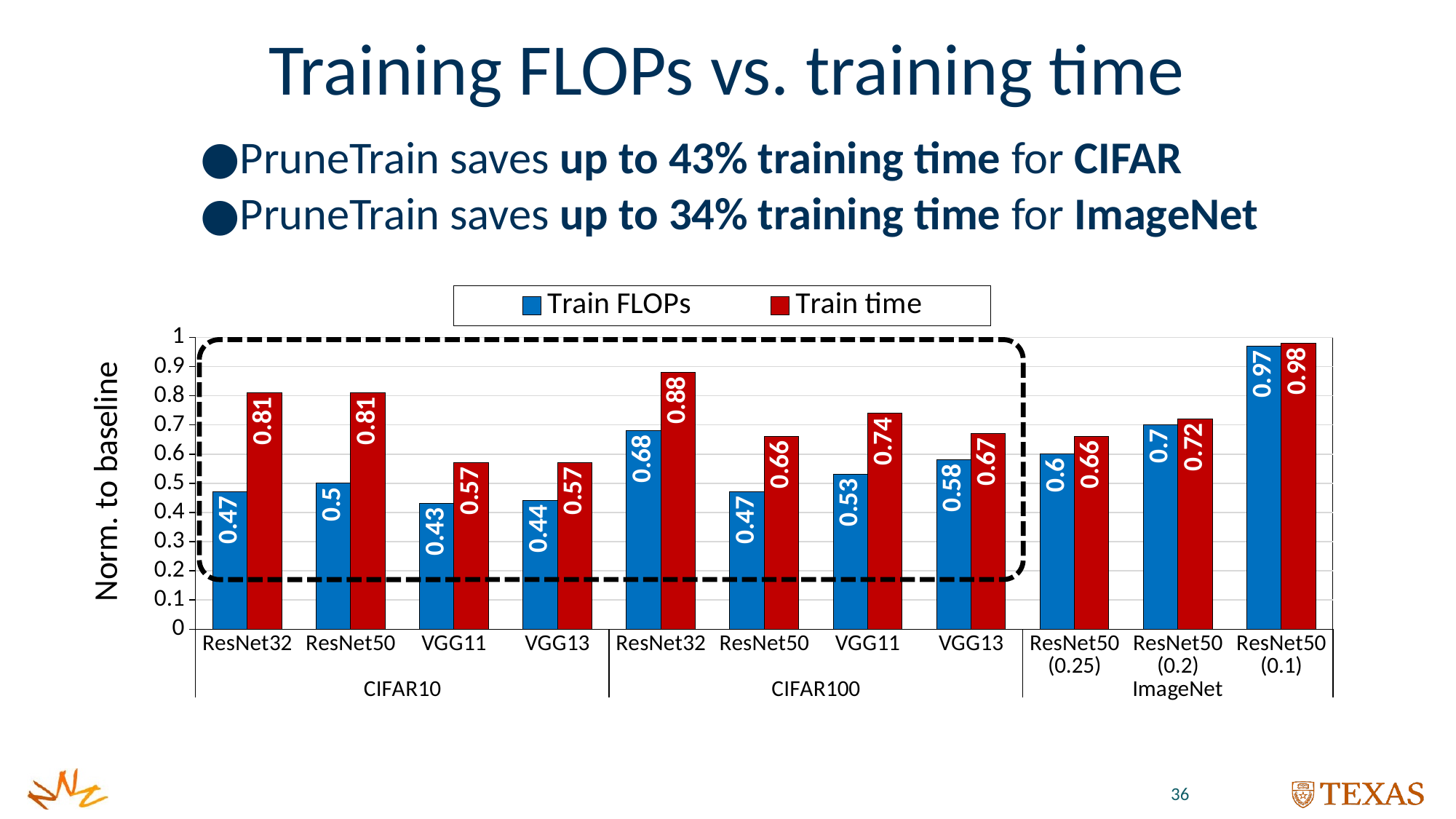
Is the Train time value for ResNet32 on CIFAR100 greater or less than 0.8? greater What kind of chart is shown on the slide? Bar chart What is the difference between the Train time and Train FLOPs values for ResNet32 on CIFAR10? 0.34 What is the Train time value for ResNet50 (0.2) on ImageNet? 0.72 How many categories are shown on the x axis? 11 How many series does the legend list? 2 Which is larger for ResNet50 on CIFAR100: Train FLOPs or Train time? Train time What is the Train FLOPs value for ResNet32 on CIFAR10? 0.47 What is the y-axis label of the chart? Norm. to baseline Which category has the lowest Train FLOPs value? VGG11 (CIFAR10) What is the Train time value for VGG11 on CIFAR100? 0.74 Which category has the highest Train time value? ResNet50 (0.1)